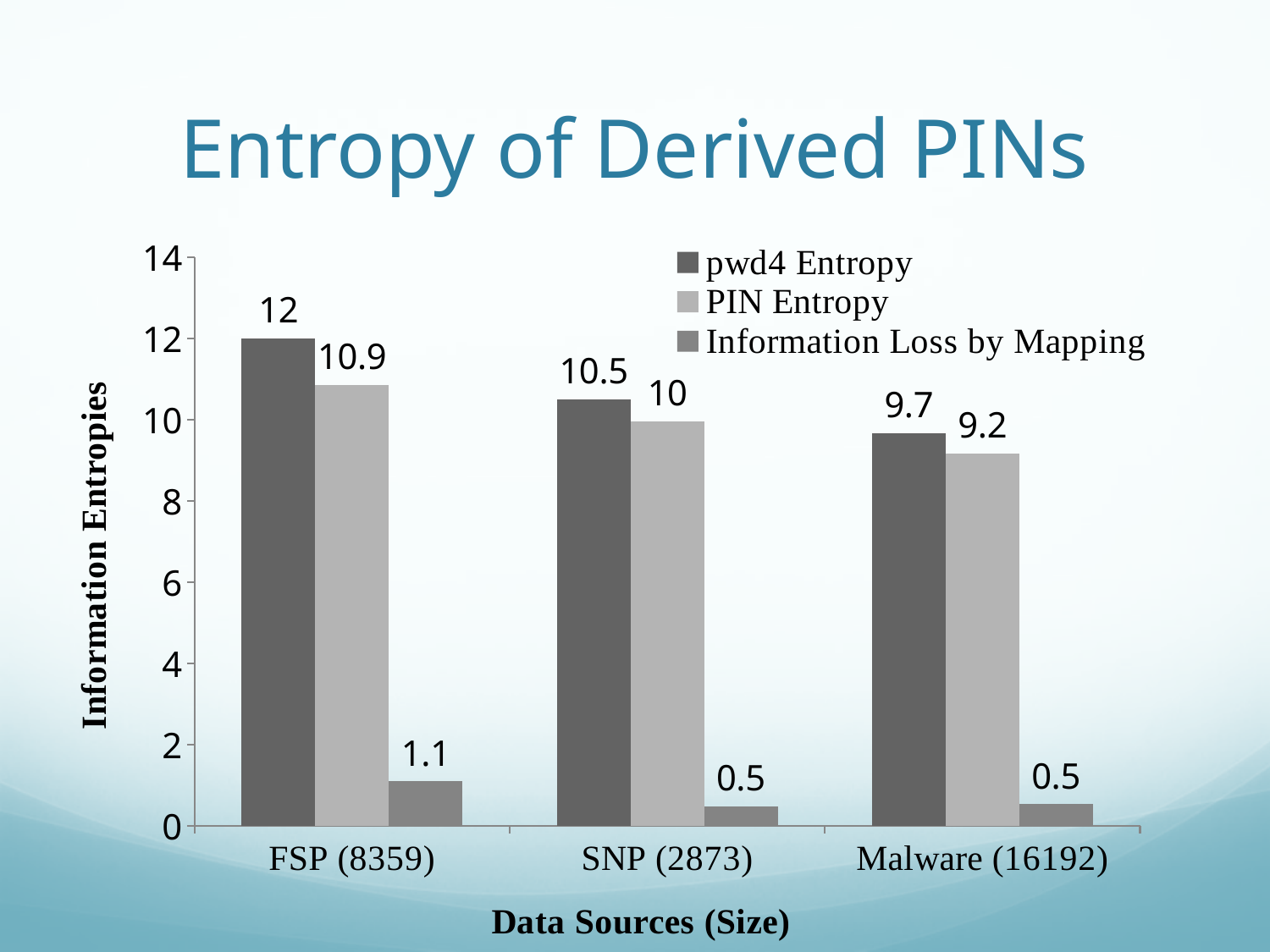
Which is larger: the PIN Entropy for FSP (8359) or the pwd4 Entropy for SNP (2873)? PIN Entropy for FSP (8359) How many series does the legend list? 3 Which data source has the highest pwd4 Entropy? FSP (8359) Which data source has the lowest PIN Entropy? Malware (16192) What is the difference between pwd4 Entropy and PIN Entropy for FSP (8359)? 1.1 What is the PIN Entropy value for SNP (2873)? 10 How many data sources are shown on the x axis? 3 Is the pwd4 Entropy value for Malware (16192) greater or less than 10? less Does the pwd4 Entropy rise or fall from FSP (8359) to Malware (16192)? fall What is the Information Loss by Mapping value for Malware (16192)? 0.5 What kind of chart is shown on the slide? bar chart What is the pwd4 Entropy value for FSP (8359)? 12